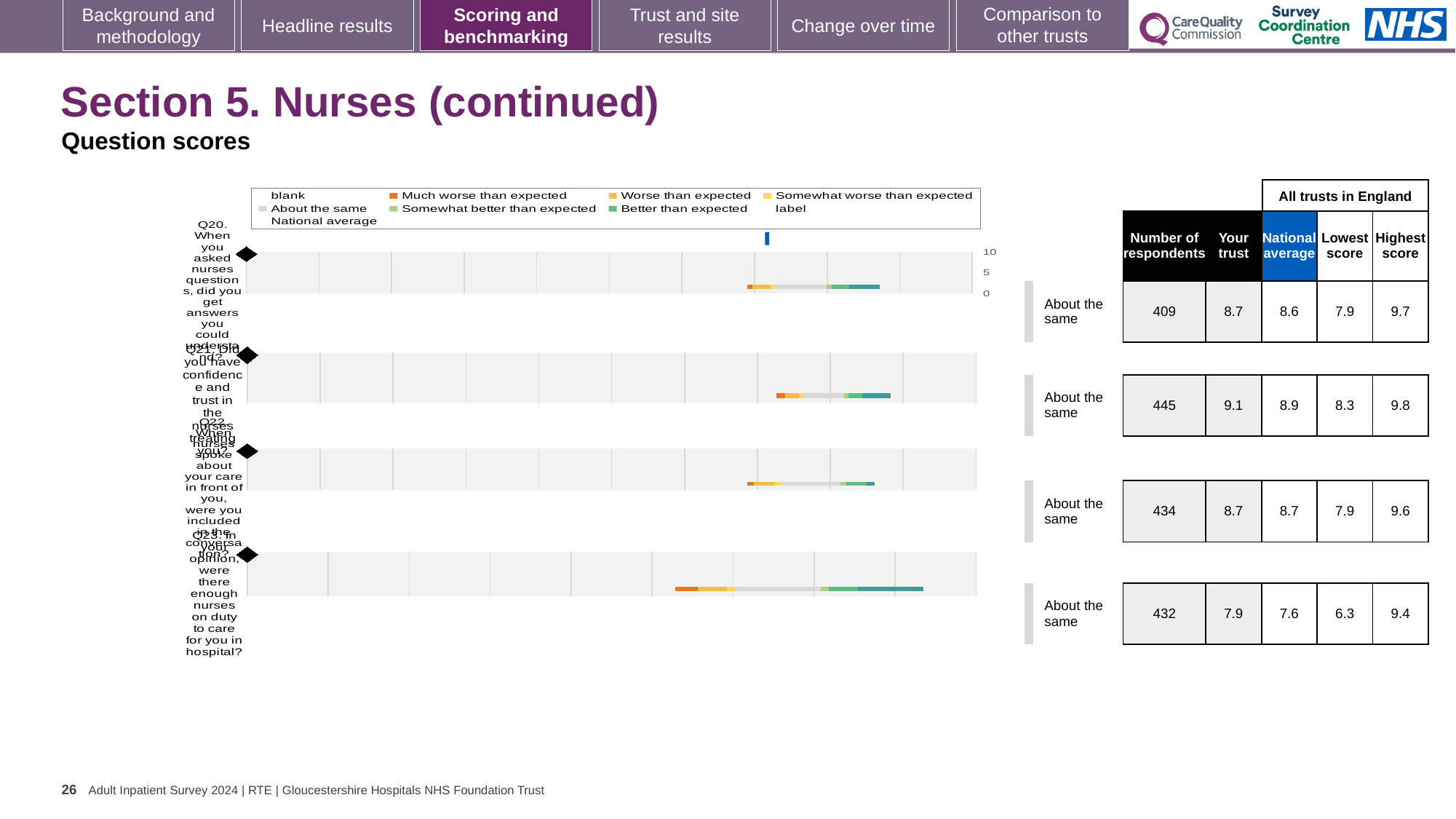
What kind of chart is used to show the question scores for Q20 to Q23? Bar chart What benchmark label is shown next to the bar for Q22? About the same In the table beside the chart, what is the 'Your trust' score for Q23 (enough nurses on duty)? 7.9 In the table beside the chart, what is the highest score across all trusts in England for Q22? 9.6 For Q23, what is the difference between the highest score (9.4) and the lowest score (6.3) in the table? 3.1 In the chart legend, what colour represents 'Much worse than expected'? Orange For Q20, which is larger: the 'Your trust' score or the national average? Your trust In the table beside the chart, how many respondents are listed for Q21 (confidence and trust in nurses)? 445 In the table beside the chart, what is the national average for Q20? 8.6 How many questions (bars) are plotted in the chart? 4 Which question has the lowest 'Your trust' score in the table beside the chart? Q23 Which question has the highest 'Your trust' score in the table beside the chart? Q21